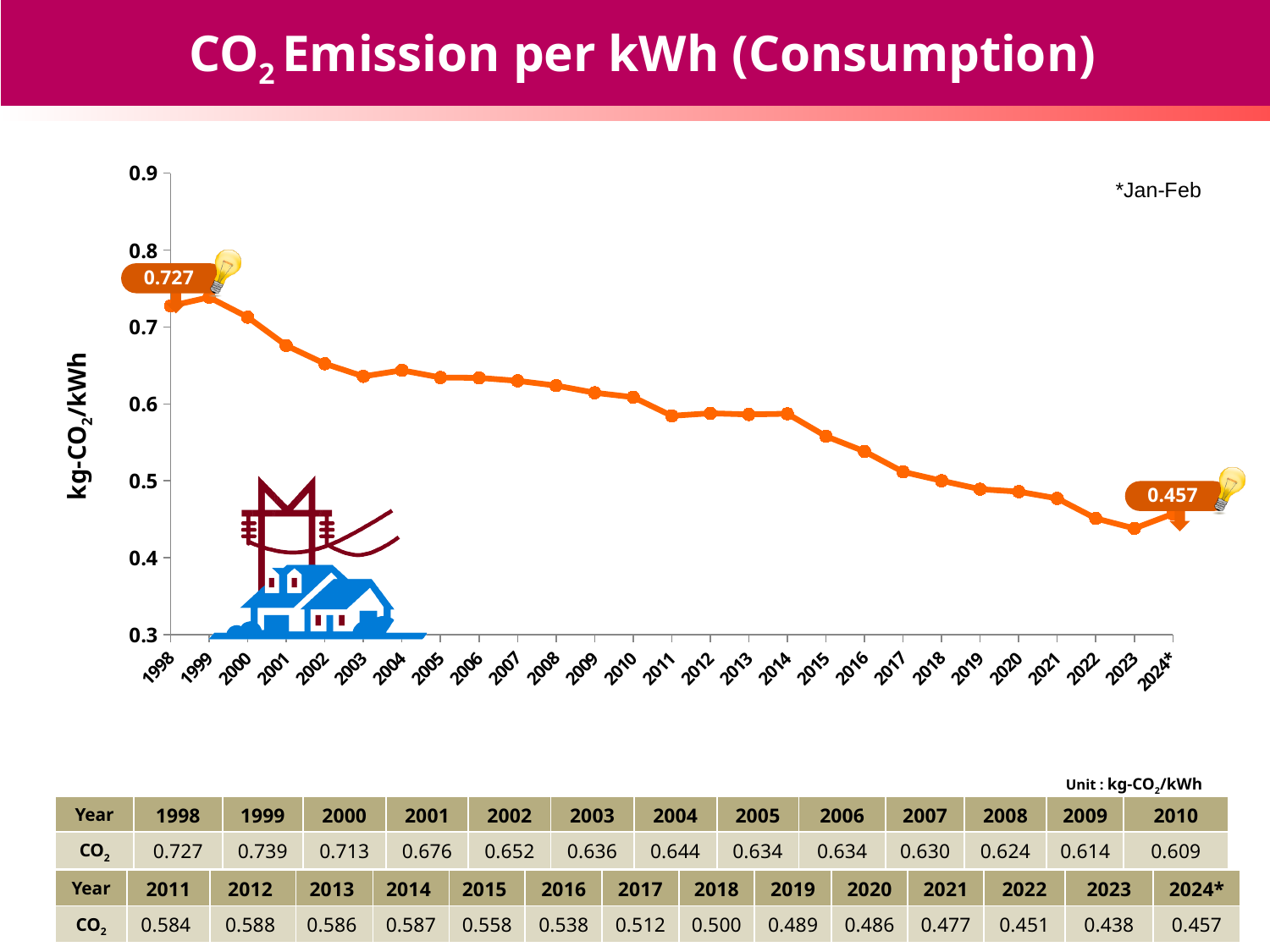
What type of chart is shown on the slide? line chart Do the values generally rise or fall from 1998 to 2024*? fall What is the CO2 emission per kWh value for 1998? 0.727 Is the value for 2016 greater or less than 0.6? less Which is larger, the value for 2003 or the value for 2004? 2004 How many years are plotted on the chart? 27 Which year has the lowest CO2 emission per kWh? 2023 What does the asterisk on 2024* indicate according to the note on the chart? Jan-Feb What is the CO2 emission per kWh value for 2024*? 0.457 What is the CO2 emission per kWh value for 2015? 0.558 What is the difference between the 1998 value and the 2024* value? 0.270 Which year has the highest CO2 emission per kWh? 1999